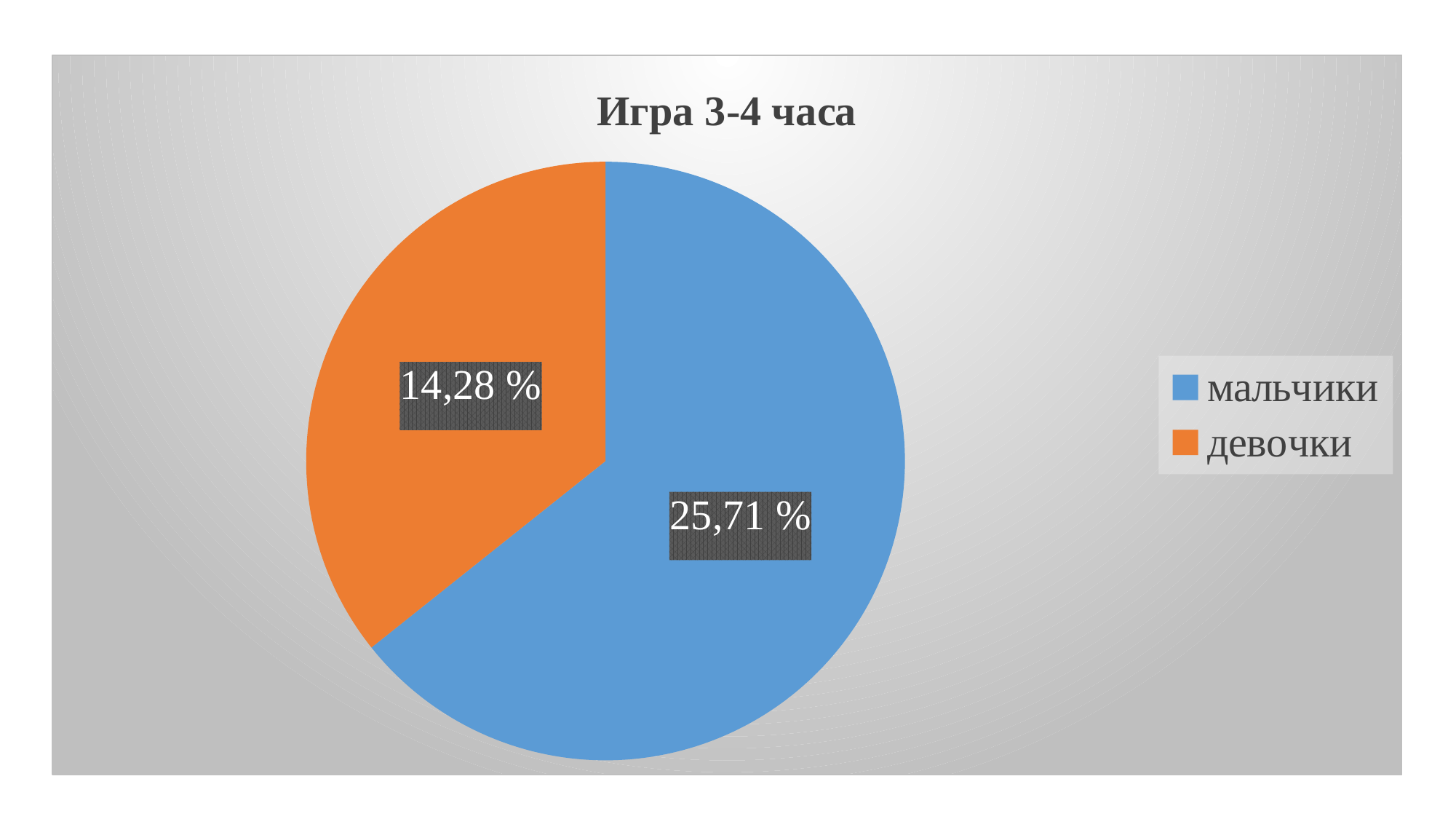
What is the difference between the value for мальчики and the value for девочки? 11,43 % What value is shown for мальчики in the pie chart? 25,71 % How many slices does the pie chart have? 2 How many entries does the legend list? 2 What kind of chart is shown on the slide? pie chart What is the title of the chart? Игра 3-4 часа Which is larger, the value for мальчики or the value for девочки? мальчики Which category has the smallest slice of the pie? девочки Which category has the largest slice of the pie? мальчики What colour is the slice for девочки? orange What value is shown for девочки in the pie chart? 14,28 %